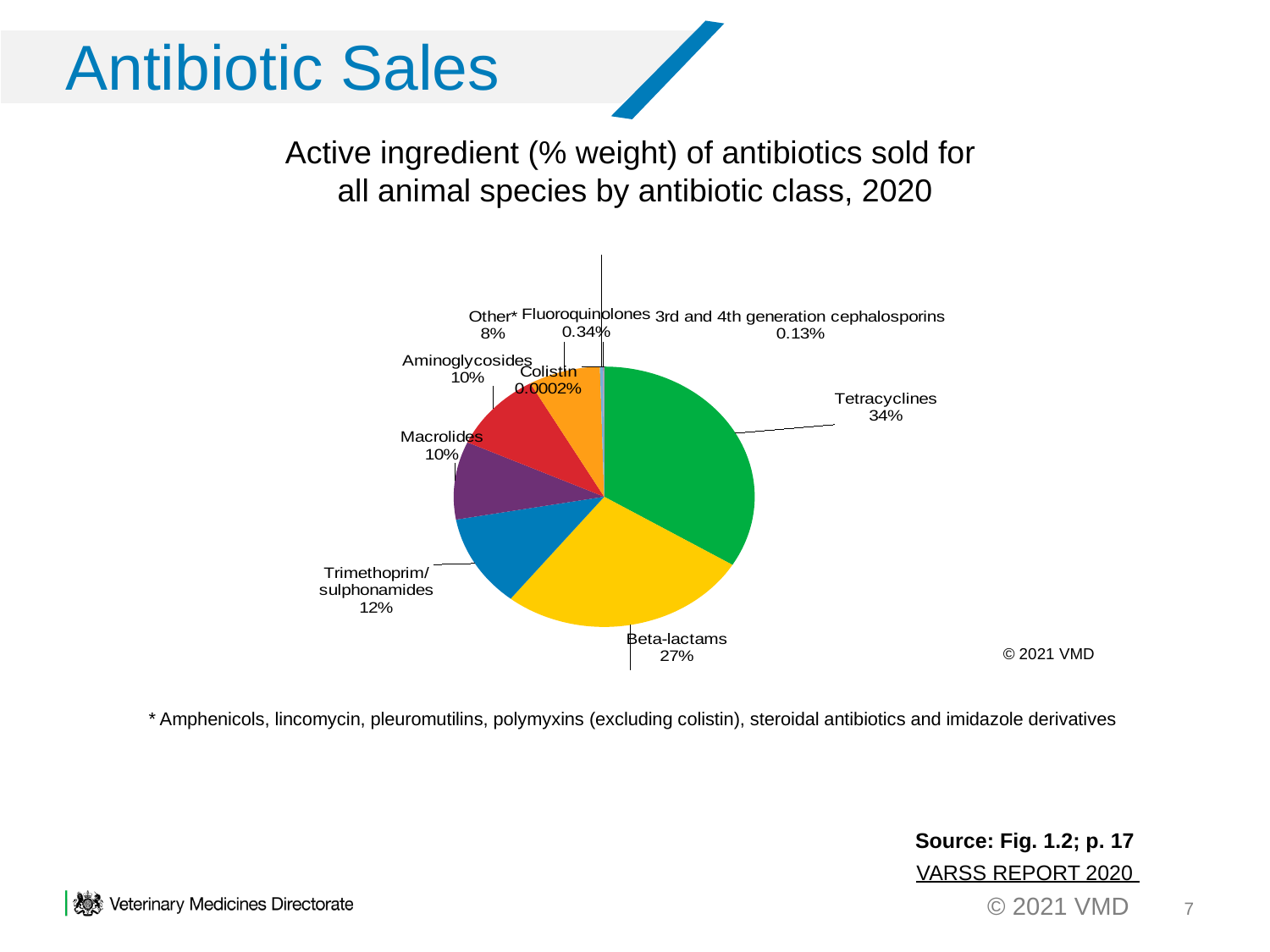
Which has a larger share, Trimethoprim/sulphonamides or Macrolides? Trimethoprim/sulphonamides Which antibiotic class has the largest share of the pie? Tetracyclines What percentage is shown for Beta-lactams? 27% What percentage is shown for Colistin? 0.0002% What percentage is shown for Trimethoprim/sulphonamides? 12% What type of chart is shown on the slide? Pie chart What percentage of antibiotic sales by weight is Tetracyclines? 34% What is the difference in percentage points between Tetracyclines and Beta-lactams? 7 Which antibiotic class has the smallest share of the pie? Colistin How many antibiotic classes (slices) are shown in the pie chart? 9 What percentage is shown for 3rd and 4th generation cephalosporins? 0.13% What percentage is shown for Fluoroquinolones? 0.34%